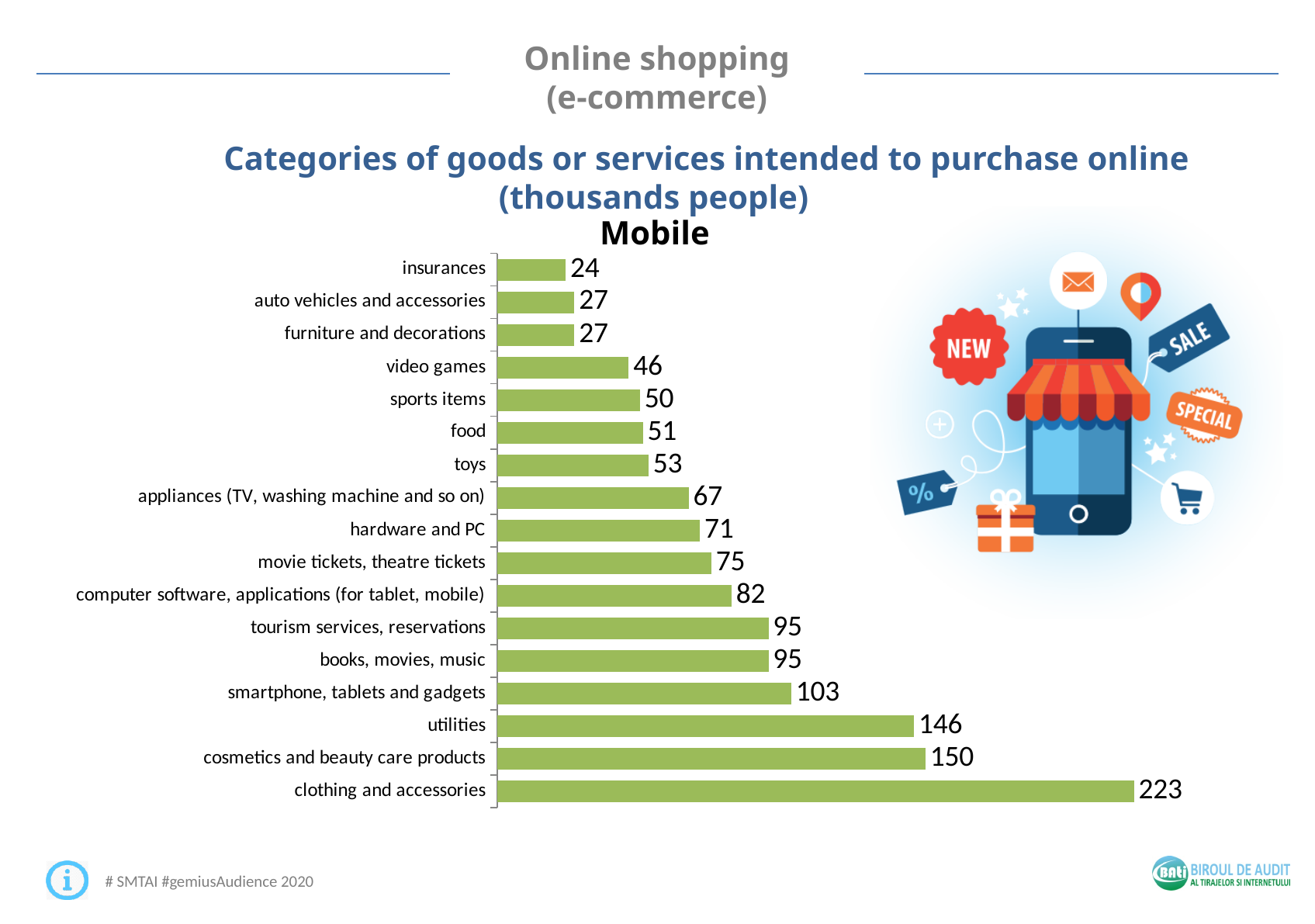
How many categories are shown in the chart? 17 What colour are the bars in the chart? green What is the difference between the values for clothing and accessories and smartphone, tablets and gadgets? 120 What is the value for hardware and PC? 71 What is the difference between the values for cosmetics and beauty care products and utilities? 4 What is the value for utilities? 146 Which category has the highest value? clothing and accessories Which category has the lowest value? insurances What is the value for clothing and accessories? 223 What is the title of the chart? Mobile What kind of chart is shown on the slide? bar chart Which is larger, the value for video games or the value for toys? toys